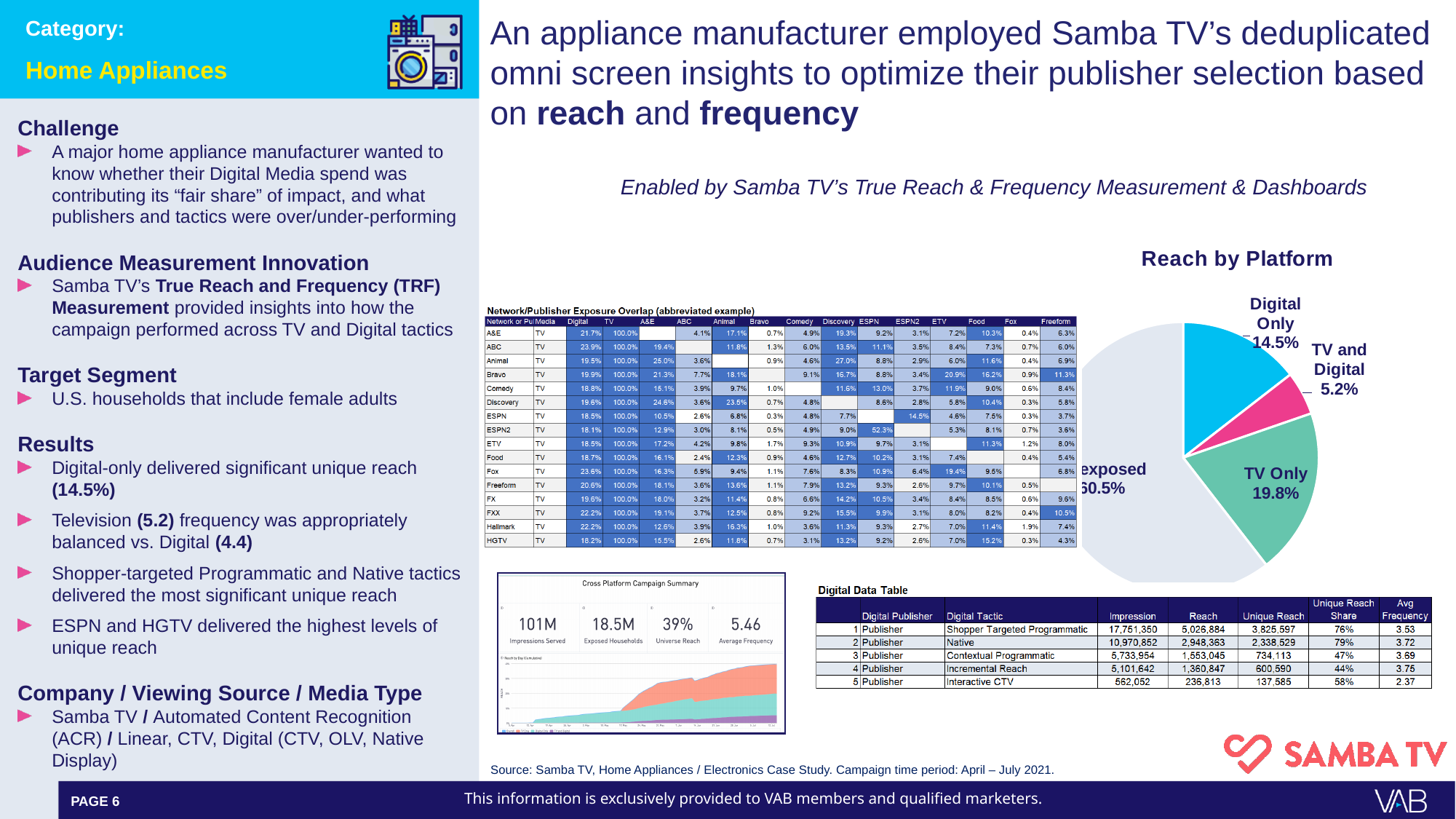
In the "Reach by Platform" pie chart, what is the difference between Digital Only and TV and Digital? 9.3% What is the title of the pie chart on the right side of the slide? Reach by Platform In the "Reach by Platform" pie chart, which is larger: TV Only or Digital Only? TV Only In the "Reach by Platform" pie chart, what is the combined share of TV Only and Digital Only? 34.3% What type of chart is the "Reach by Platform" chart? pie chart How many slices does the "Reach by Platform" pie chart have? 4 In the "Reach by Platform" pie chart, what colour is the TV Only slice? teal green In the "Reach by Platform" pie chart, what is the value for TV Only? 19.8% In the "Reach by Platform" pie chart, what is the value for TV and Digital? 5.2% In the "Reach by Platform" pie chart, what is the difference between TV Only and Digital Only? 5.3% In the "Reach by Platform" pie chart, what is the value for Digital Only? 14.5% In the "Reach by Platform" pie chart, which slice is the smallest? TV and Digital